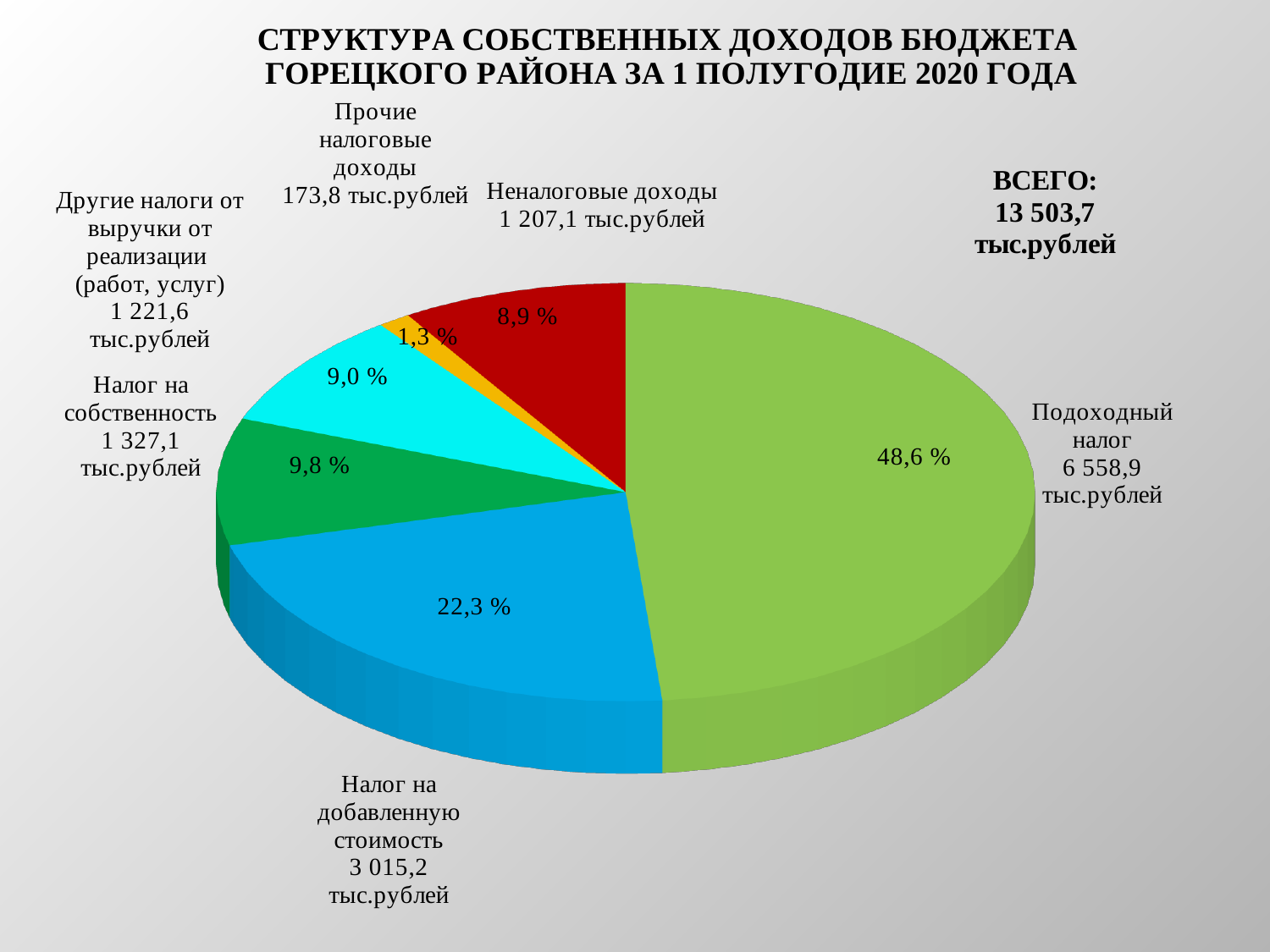
What share of the pie does Налог на собственность represent? 9,8 % How many slices does the pie chart have? 6 What total (ВСЕГО) is shown on the slide? 13 503,7 тыс.рублей What share of the pie does Подоходный налог represent? 48,6 % Which is larger, Налог на собственность or Другие налоги от выручки от реализации (работ, услуг)? Налог на собственность Which category has the largest slice? Подоходный налог Which category has the smallest slice? Прочие налоговые доходы What is the value for Подоходный налог? 6 558,9 тыс.рублей What is the value for Неналоговые доходы? 1 207,1 тыс.рублей What is the value for Налог на добавленную стоимость? 3 015,2 тыс.рублей What type of chart is shown on the slide? pie chart What is the difference between Подоходный налог and Налог на добавленную стоимость? 3 543,7 тыс.рублей